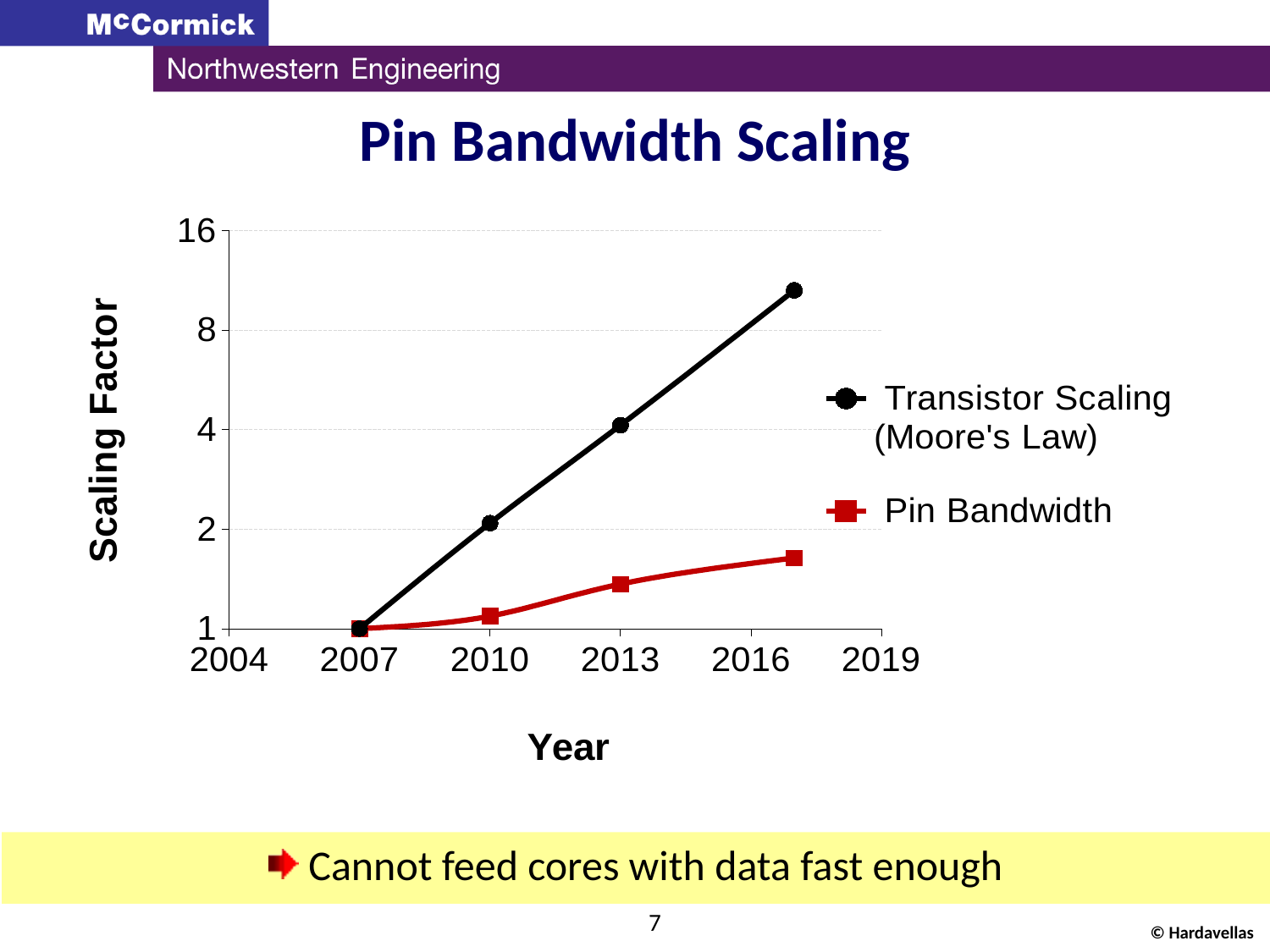
Is the value for Pin Bandwidth in 2013 greater or less than 2? less What is the label of the vertical axis of the chart? Scaling Factor How many data points are plotted for the Pin Bandwidth series? 4 How many series does the chart's legend list? 2 What kind of chart is shown on the slide? line chart Which series has the higher value at the last plotted point, Transistor Scaling (Moore's Law) or Pin Bandwidth? Transistor Scaling (Moore's Law) What is the scaling factor for Transistor Scaling (Moore's Law) in 2007? 1 Is the value for Transistor Scaling (Moore's Law) at its last point (around 2017) greater or less than 8? greater Is the value for Pin Bandwidth at its last point (around 2017) greater or less than 2? less Do the values for Transistor Scaling (Moore's Law) rise or fall as the year increases? rise What is the scaling factor for Pin Bandwidth in 2007? 1 What is the title of the chart on the slide? Pin Bandwidth Scaling